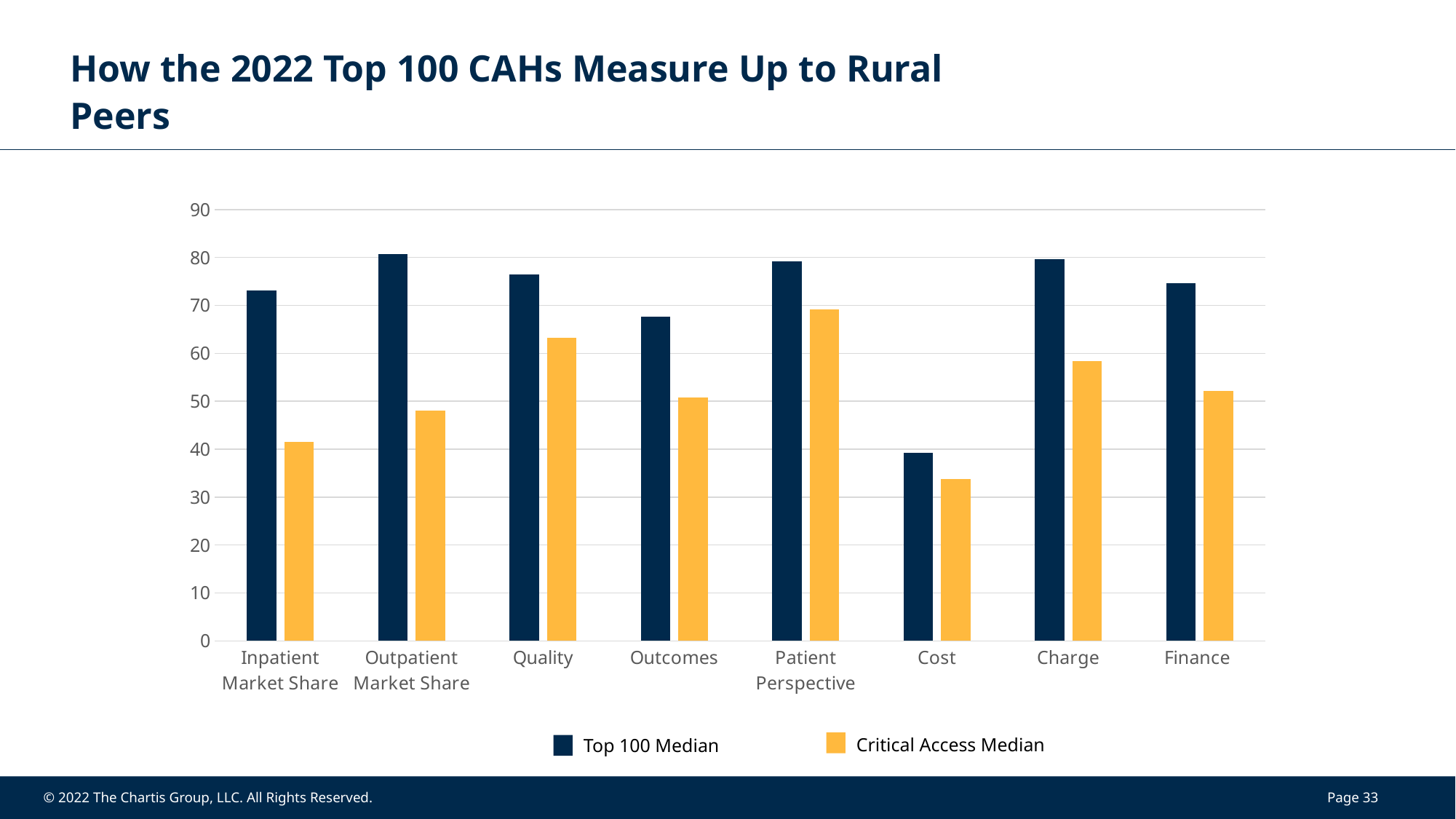
Which category has the highest Critical Access Median value? Patient Perspective What kind of chart is shown on the slide? Bar chart Is the Critical Access Median value for Charge greater or less than 60? less Which category has the lowest Top 100 Median value? Cost How many series does the legend list? 2 Which category has the lowest Critical Access Median value? Cost How many categories are shown on the x axis? 8 Which colour represents the Critical Access Median series? Yellow Which is larger for Quality: the Top 100 Median or the Critical Access Median? Top 100 Median Is the Critical Access Median value for Quality greater or less than 60? greater